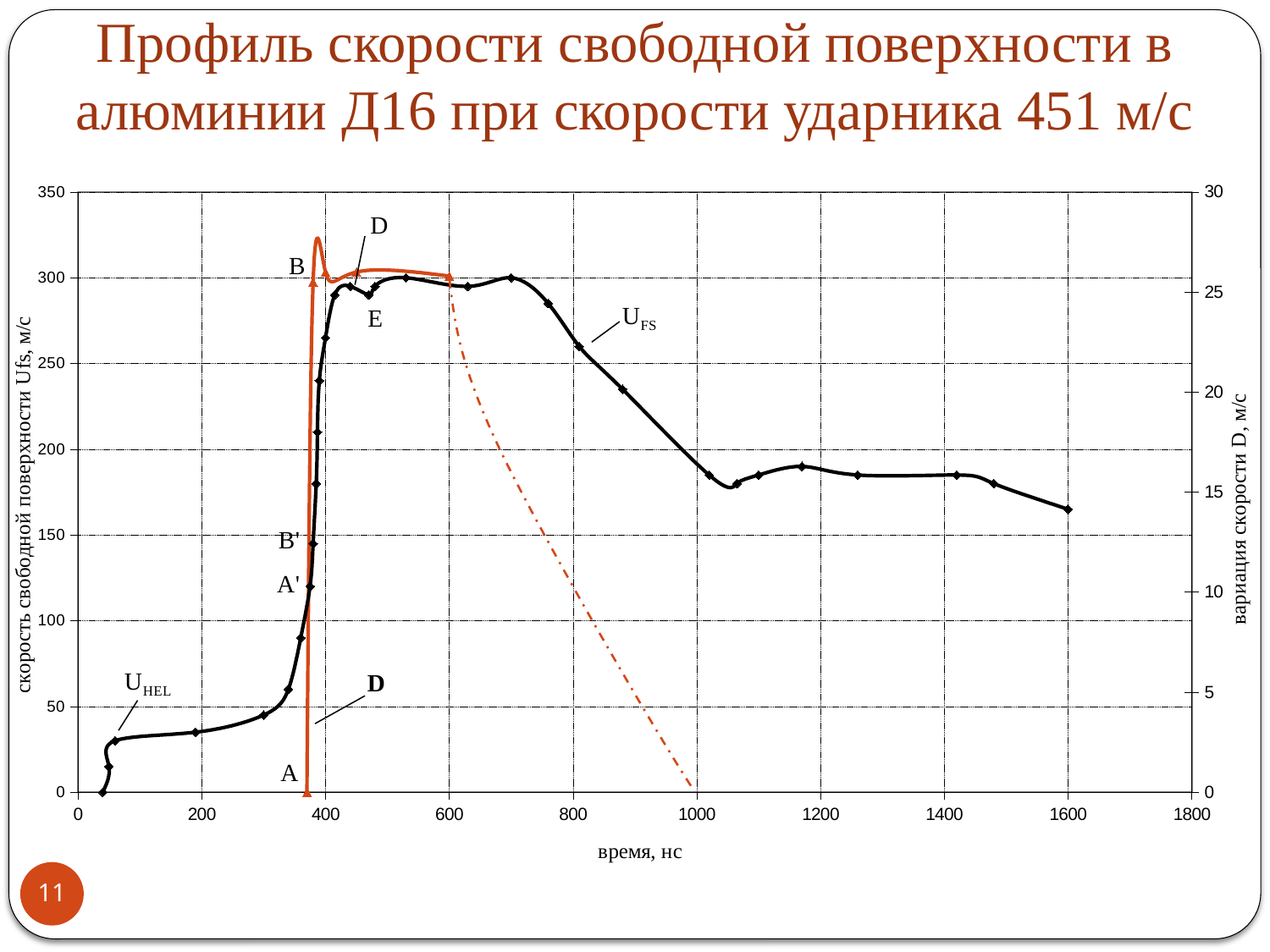
Is the free-surface velocity (black curve) at 1600 ns greater or less than 150? greater What is the title of the slide's chart? Профиль скорости свободной поверхности в алюминии Д16 при скорости ударника 451 м/с Is the free-surface velocity (black curve) at 1200 ns greater or less than 200? less Is the free-surface velocity (black curve) at 700 ns greater or less than 250? greater Between 300 ns and 400 ns, does the black free-surface velocity curve rise or fall? rise What is the label of the right-hand vertical axis? вариация скорости D, м/с What kind of chart is shown on the slide? line chart Between 800 ns and 1000 ns, does the black free-surface velocity curve rise or fall? fall